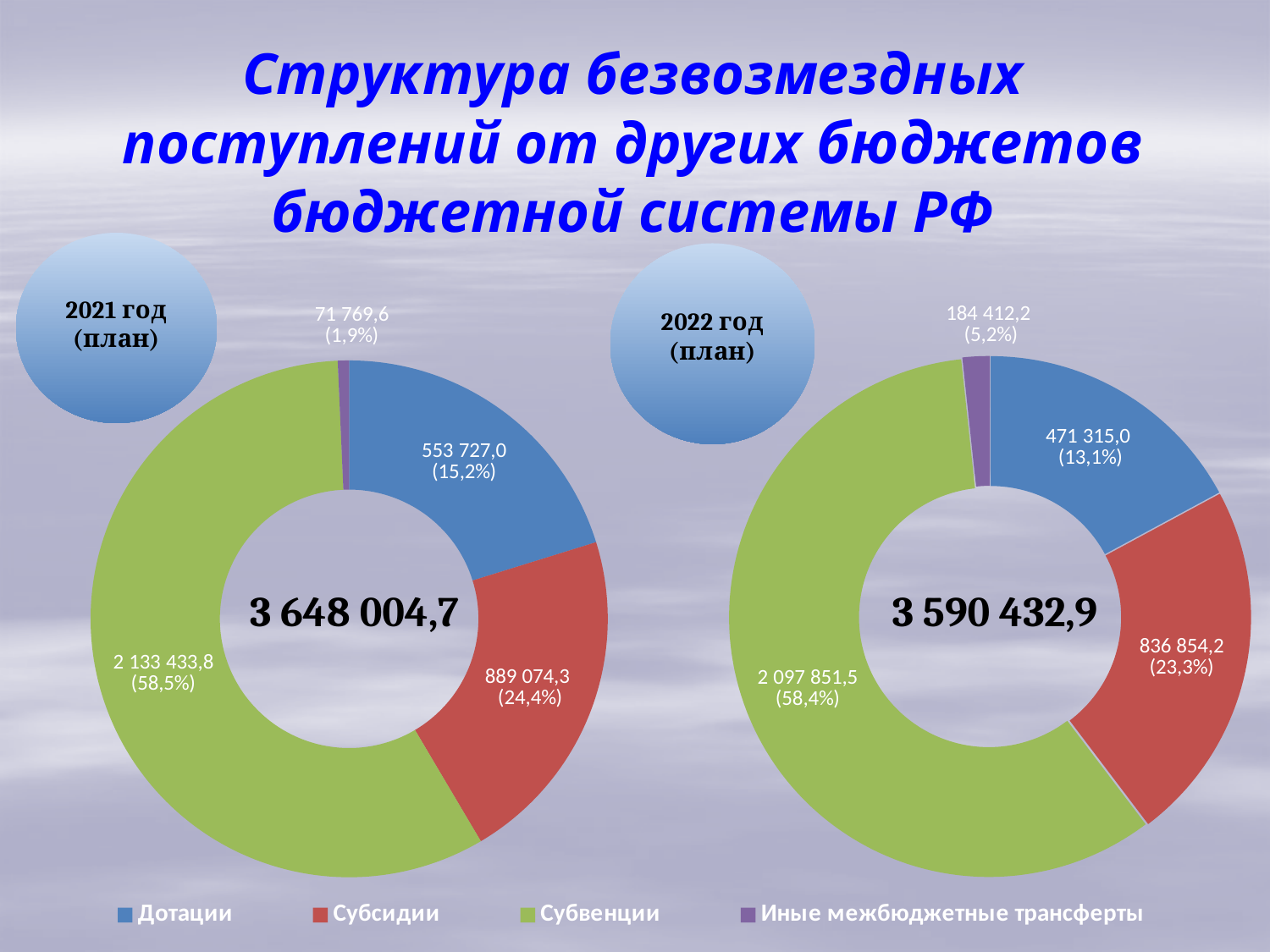
In the 2022 год (план) chart, which category has the smallest value? Иные межбюджетные трансферты In the 2022 год (план) chart, what value is shown for Дотации? 471 315,0 How many categories does each doughnut chart contain? 4 In the 2021 год (план) chart, what value is shown for Субвенции? 2 133 433,8 What total is printed in the centre of the 2022 год (план) chart? 3 590 432,9 What type of chart is used on this slide? Doughnut (pie) chart In the 2021 год (план) chart, which is larger: Дотации or Субсидии? Субсидии In the 2022 год (план) chart, what share of the total do Субсидии make up? 23,3% In the 2021 год (план) chart, which category has the largest value? Субвенции In the 2021 год (план) chart, what share of the total do Иные межбюджетные трансферты make up? 1,9% Which colour represents Субвенции in the legend? Green What is the difference between the Субсидии value in the 2021 год (план) chart and the Субсидии value in the 2022 год (план) chart? 52 220,1